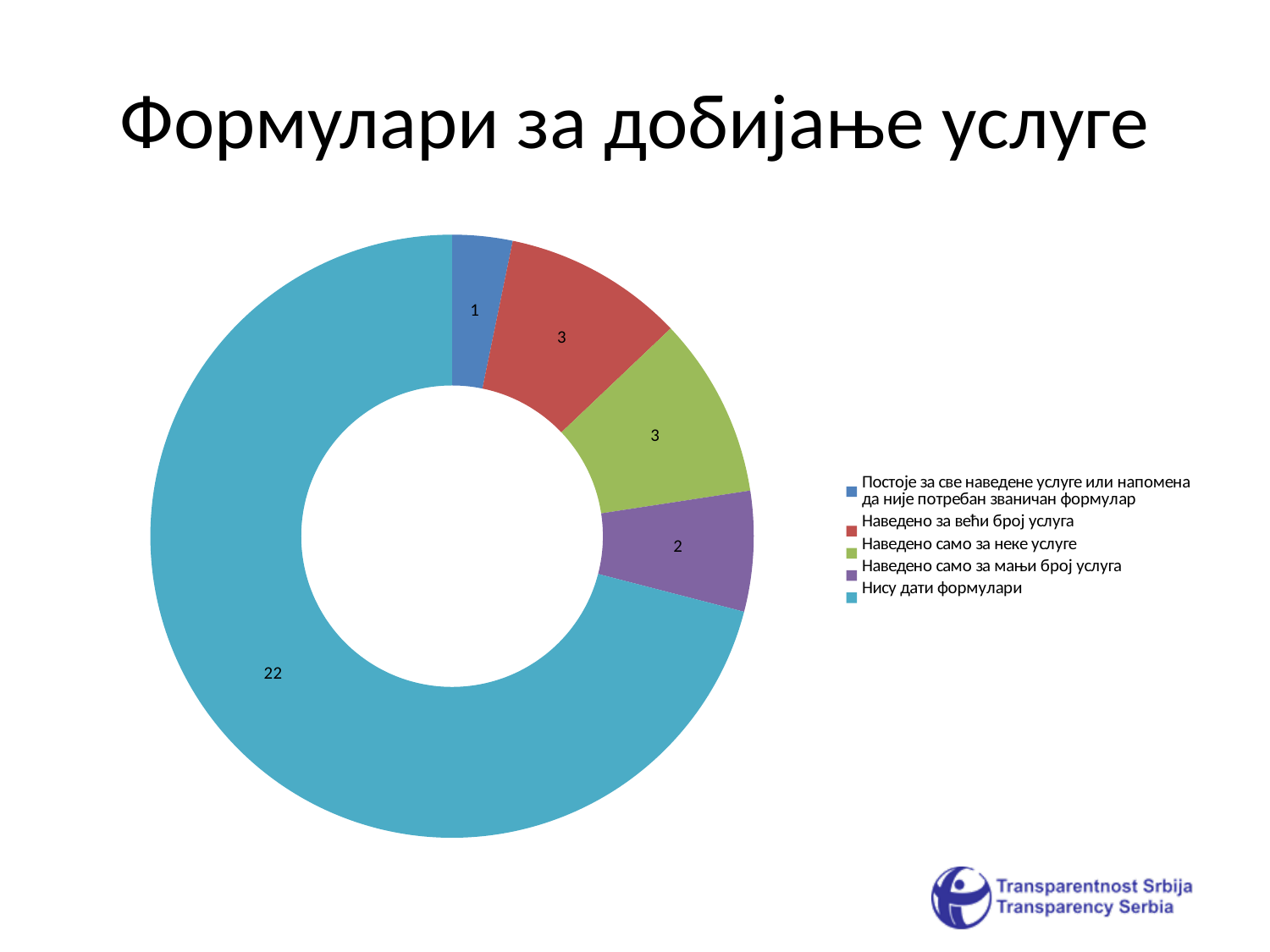
What is the value for "Постоје за све наведене услуге или напомена да није потребан званичан формулар"? 1 What is the value for "Наведено само за мањи број услуга"? 2 Which is larger, the value for "Наведено само за мањи број услуга" or the value for "Наведено за већи број услуга"? Наведено за већи број услуга What is the value for "Наведено за већи број услуга"? 3 What is the value for "Нису дати формулари"? 22 Which category has the smallest value? Постоје за све наведене услуге или напомена да није потребан званичан формулар How many categories does the chart show? 5 Which category has the largest value? Нису дати формулари What type of chart is shown on the slide? Doughnut chart What is the total of all the values shown in the chart? 31 What is the difference between the values for "Нису дати формулари" and "Наведено само за неке услуге"? 19 What is the title of the slide? Формулари за добијање услуге